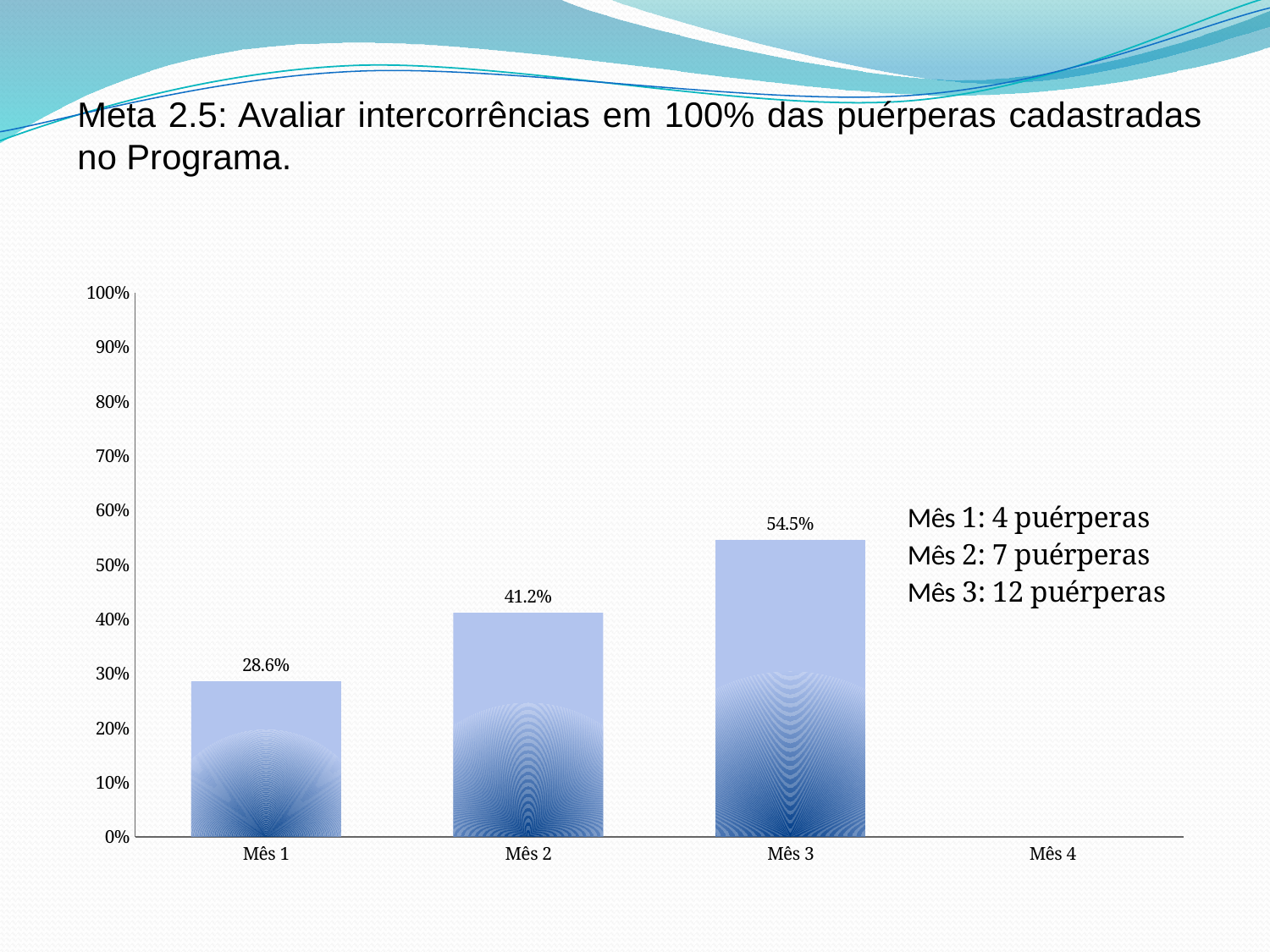
What is the difference between the values for Mês 3 and Mês 1? 25.9% Is the value for Mês 3 greater or less than 50%? greater Among the months with a plotted bar, which has the lowest value? Mês 1 What is the difference between the values for Mês 2 and Mês 1? 12.6% What is the value for Mês 1? 28.6% What is the value for Mês 2? 41.2% Which month has the highest value? Mês 3 What is the value for Mês 3? 54.5% Which is larger, the value for Mês 2 or the value for Mês 3? Mês 3 What kind of chart is shown on the slide? Bar chart Do the values rise or fall from Mês 1 to Mês 3? Rise How many categories are shown on the x axis? 4